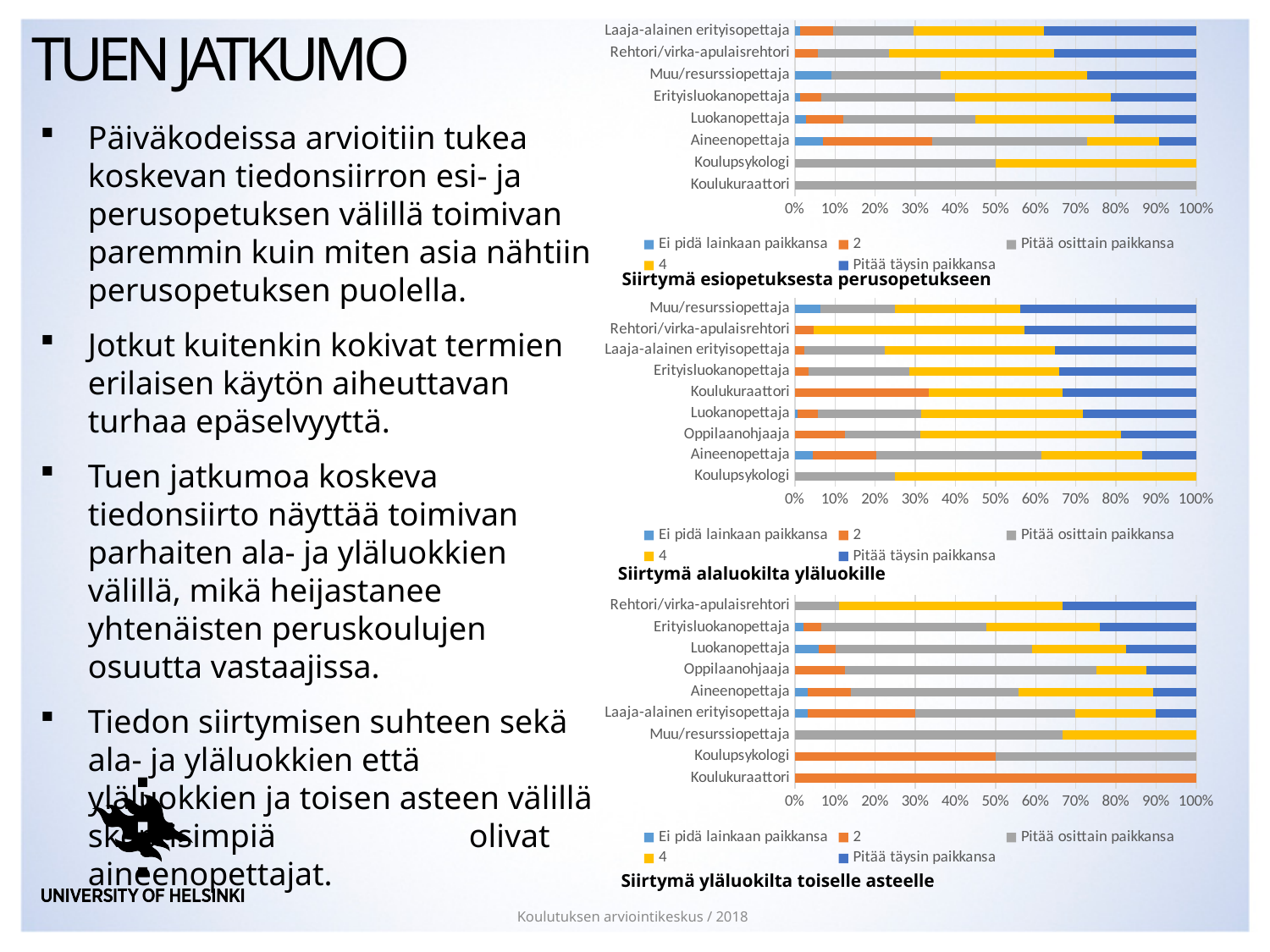
How many categories are shown in the middle chart, 'Siirtymä alaluokilta yläluokille'? 9 In the legend of the top chart, which series is shown in yellow? 4 How many categories are shown in the top chart, 'Siirtymä esiopetuksesta perusopetukseen'? 8 How many series does the legend of the middle chart, 'Siirtymä alaluokilta yläluokille', list? 5 In the bottom chart, 'Siirtymä yläluokilta toiselle asteelle', is the share for series '2' for Koulukuraattori greater or less than 90%? greater What is the title of the bottom chart on the slide? Siirtymä yläluokilta toiselle asteelle In the middle chart, 'Siirtymä alaluokilta yläluokille', is the share for series '4' for Koulupsykologi greater or less than 60%? greater What type of chart is the top chart, 'Siirtymä esiopetuksesta perusopetukseen'? Stacked bar chart In the top chart, 'Siirtymä esiopetuksesta perusopetukseen', which has the larger 'Pitää osittain paikkansa' share, Koulukuraattori or Koulupsykologi? Koulukuraattori In the bottom chart, 'Siirtymä yläluokilta toiselle asteelle', is the 'Pitää täysin paikkansa' share for Rehtori/virka-apulaisrehtori greater or less than 20%? greater How many categories are shown in the bottom chart, 'Siirtymä yläluokilta toiselle asteelle'? 9